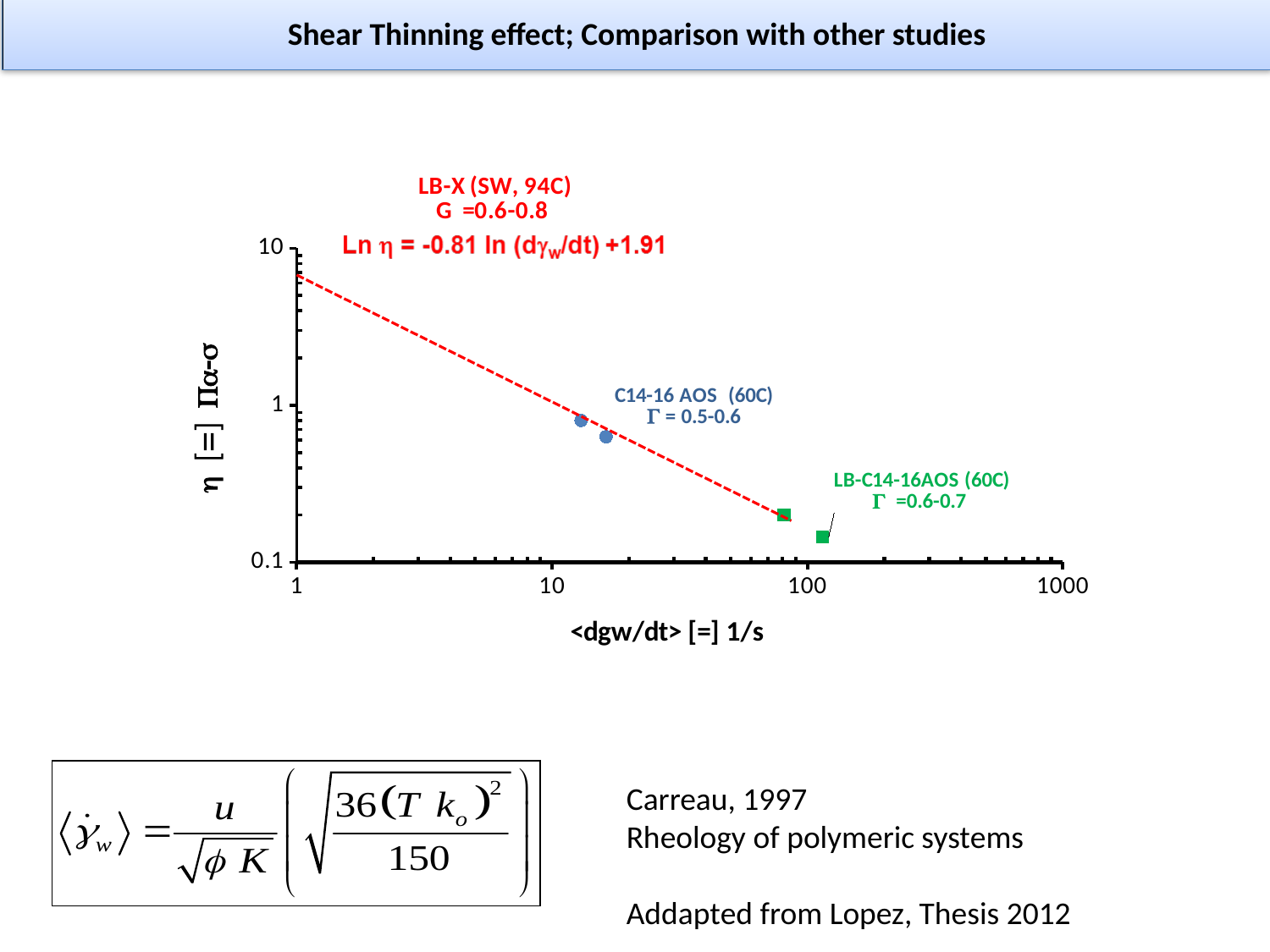
Are the shear rate values for the C14-16 AOS (60C) points greater or less than 10? greater What is the label of the x axis of the chart? <dgw/dt> [=] 1/s What is the slope coefficient in the fitted equation shown for LB-X (SW, 94C)? -0.81 Is the viscosity of the C14-16 AOS (60C) points larger or smaller than that of the LB-C14-16AOS (60C) points? larger What is the intercept in the fitted equation Ln η = -0.81 ln(dγw/dt) + ... shown on the chart? 1.91 What is the title of the slide containing the chart? Shear Thinning effect; Comparison with other studies Which group of points has the lowest viscosity on the chart? LB-C14-16AOS (60C) What kind of chart is shown on the slide? scatter chart Are the viscosity values for the LB-C14-16AOS (60C) points greater or less than 0.1? greater Are the viscosity values for the C14-16 AOS (60C) points greater or less than 1? less How many data points are plotted on the chart (excluding the dashed line)? 4 Do the viscosity values rise or fall as the shear rate increases along the x axis? fall